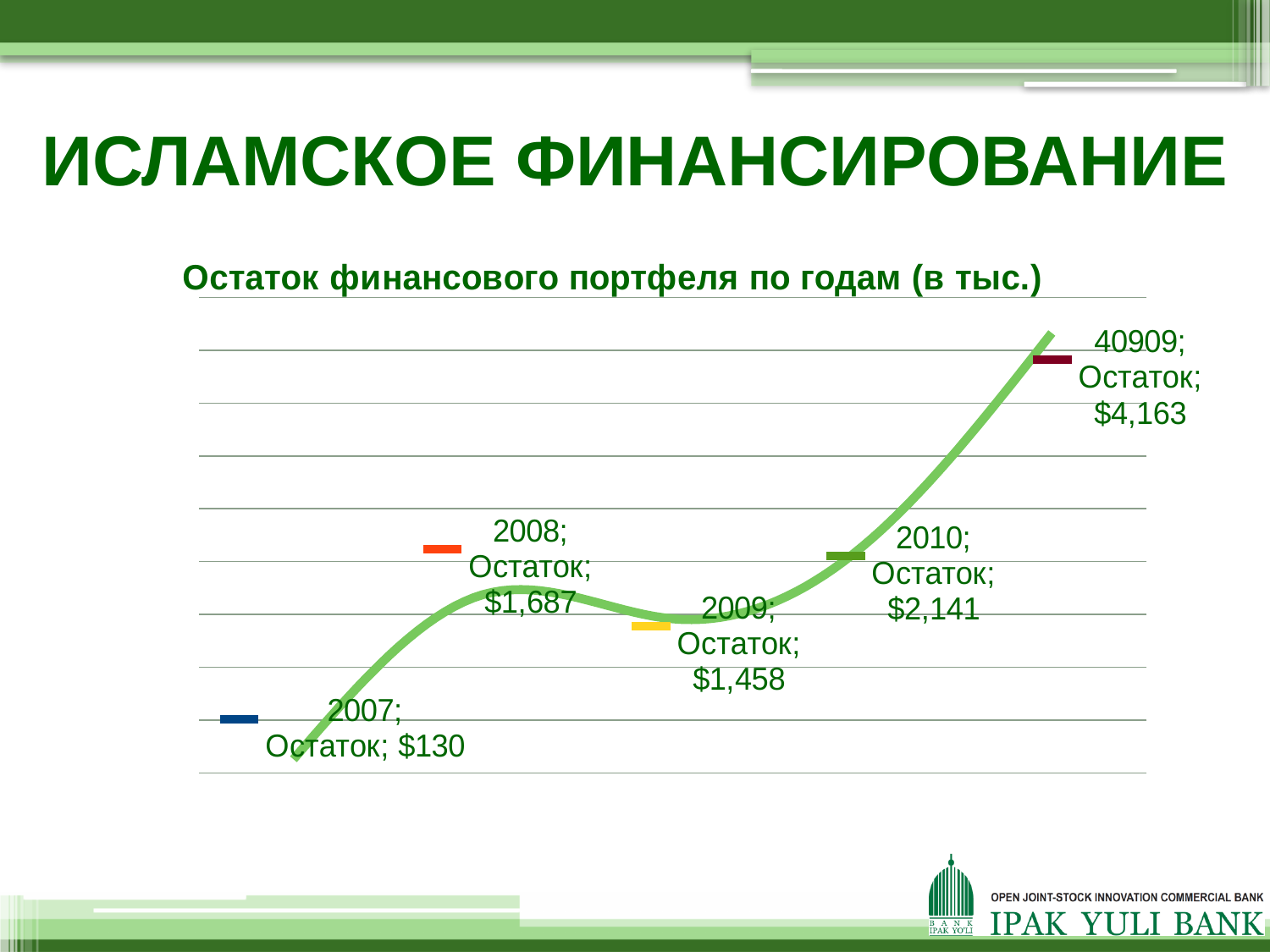
What is the difference between the values for 2010 and 2009? $683 What is the value of Остаток for 2008? $1,687 Which is larger, the value for 2008 or the value for 2009? 2008 How many data points are plotted on the chart? 5 Which point on the chart has the highest value? 40909 What is the value of Остаток for 2009? $1,458 Which year has the lowest value on the chart? 2007 What type of chart is shown on the slide? line chart What is the value of Остаток for 2007? $130 What is the value of Остаток for the last point, labelled 40909? $4,163 What is the value of Остаток for 2010? $2,141 What is the title of the chart on the slide? Остаток финансового портфеля по годам (в тыс.)